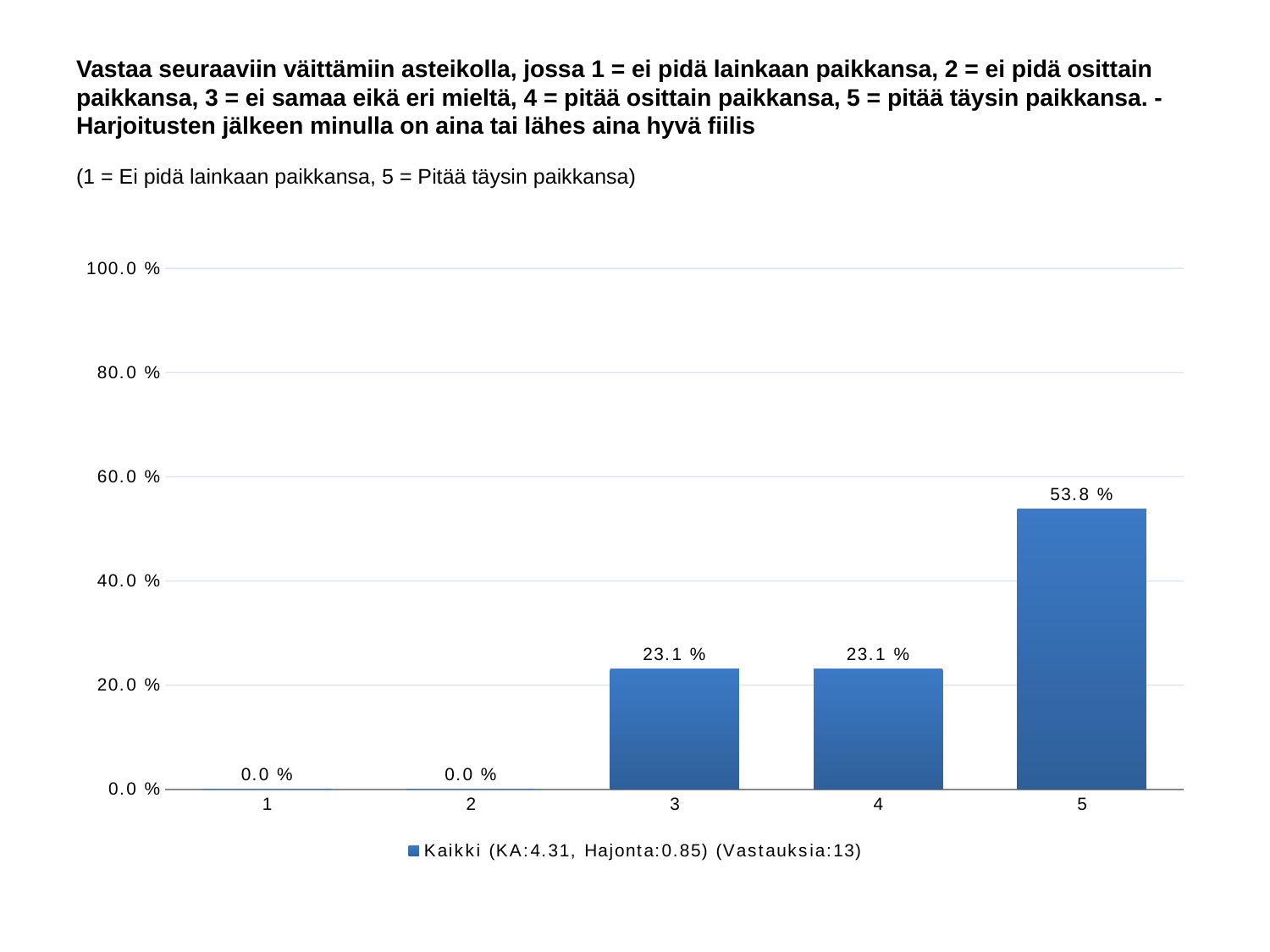
How many series does the legend list? 1 What mean (KA) value is given in the legend? 4.31 What is the value for category 3? 23.1 % What is the value for category 1? 0.0 % What kind of chart is shown? bar chart What is the difference between the values for category 5 and category 4? 30.7 % Is the value for category 5 greater or less than 40.0 %? greater How many categories are shown on the x axis? 5 How many responses (Vastauksia) does the legend report? 13 What is the value for category 5? 53.8 % Which is larger, the value for category 3 or the value for category 5? 5 Which category has the highest value? 5